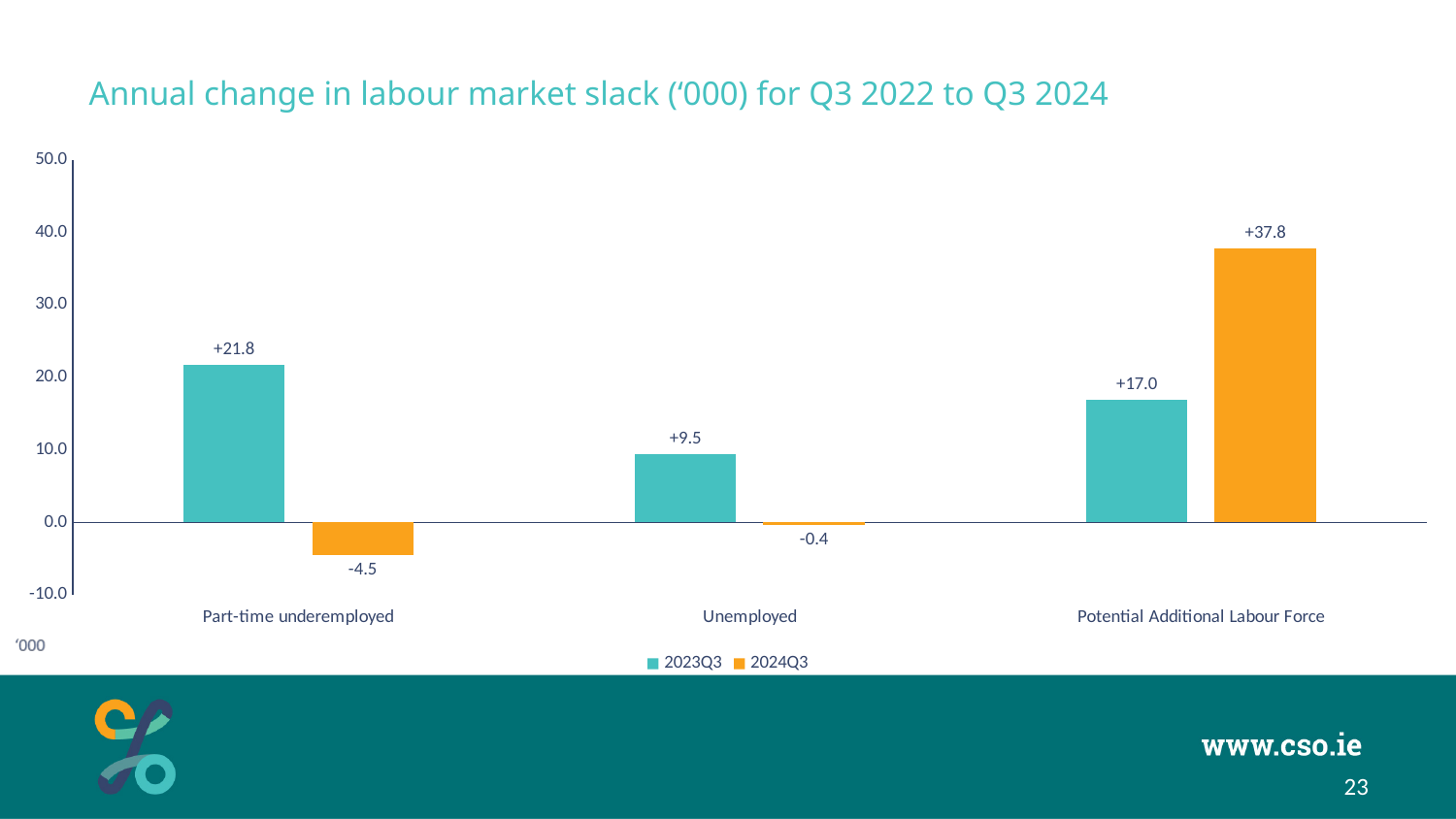
How many categories are shown on the x axis? 3 For Unemployed, which series has the larger value, 2023Q3 or 2024Q3? 2023Q3 What is the difference between the 2024Q3 and 2023Q3 values for Potential Additional Labour Force? 20.8 Which category has the highest 2023Q3 value? Part-time underemployed What kind of chart is shown on the slide? Bar chart Which category has the lowest 2024Q3 value? Part-time underemployed How many series does the legend list? 2 What is the 2024Q3 value for Potential Additional Labour Force? +37.8 What is the 2024Q3 value for Unemployed? -0.4 Is the 2023Q3 value for Potential Additional Labour Force greater or less than 20.0? less What is the 2023Q3 value for Part-time underemployed? +21.8 What is the 2024Q3 value for Part-time underemployed? -4.5